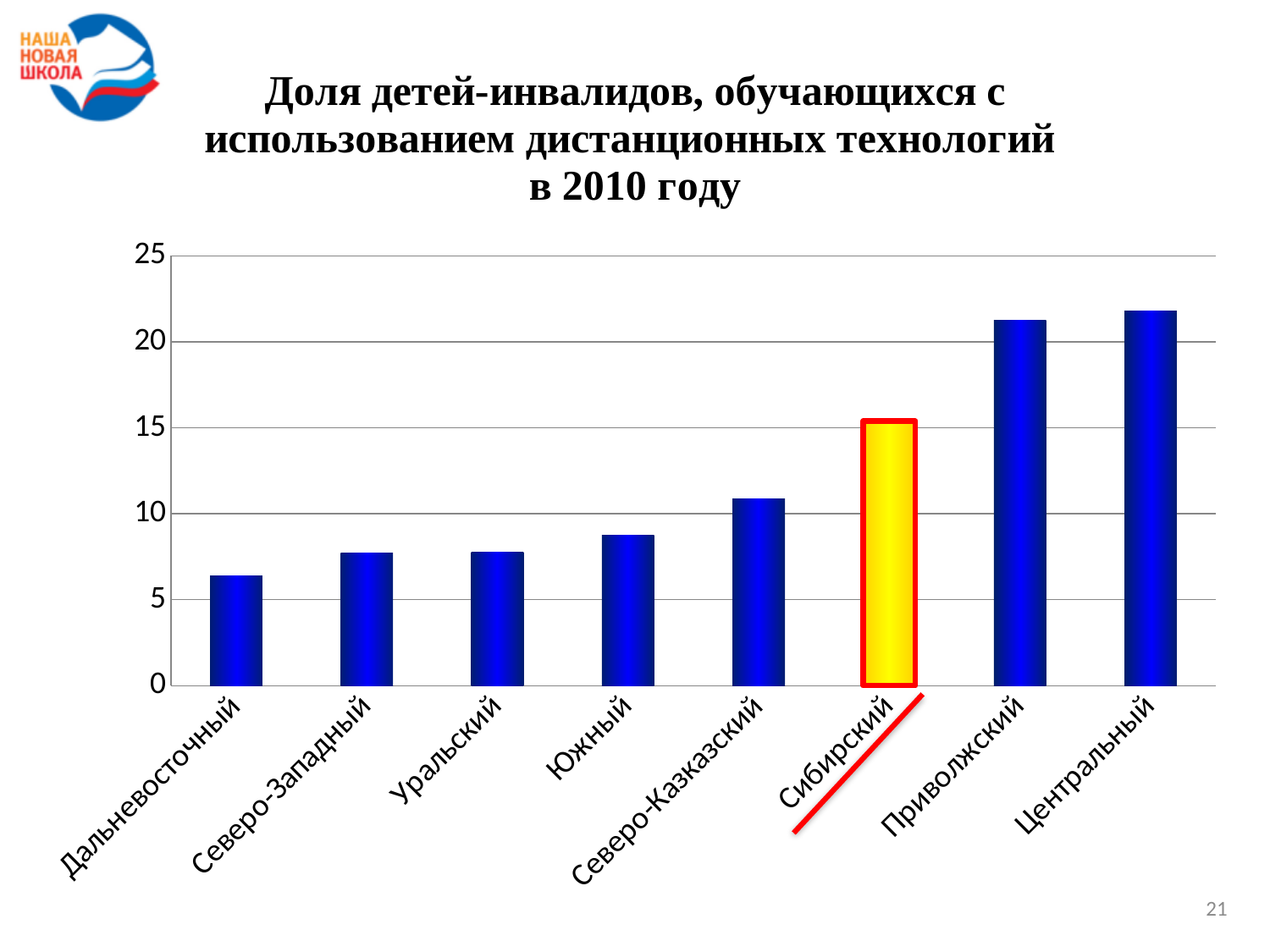
Which is larger, the value for Южный or the value for Уральский? Южный Which is larger, the value for Сибирский or the value for Северо-Кавказский? Сибирский Which region has the lowest value on the chart? Дальневосточный Is the value for Приволжский greater or less than 20? greater Is the value for Дальневосточный greater or less than 10? less Is the value for Сибирский greater or less than 10? greater Do the values generally rise or fall moving from left to right along the x axis? rise Which region's bar is highlighted in yellow with a red outline? Сибирский What kind of chart is shown on the slide? bar chart How many regions (categories) are plotted on the chart? 8